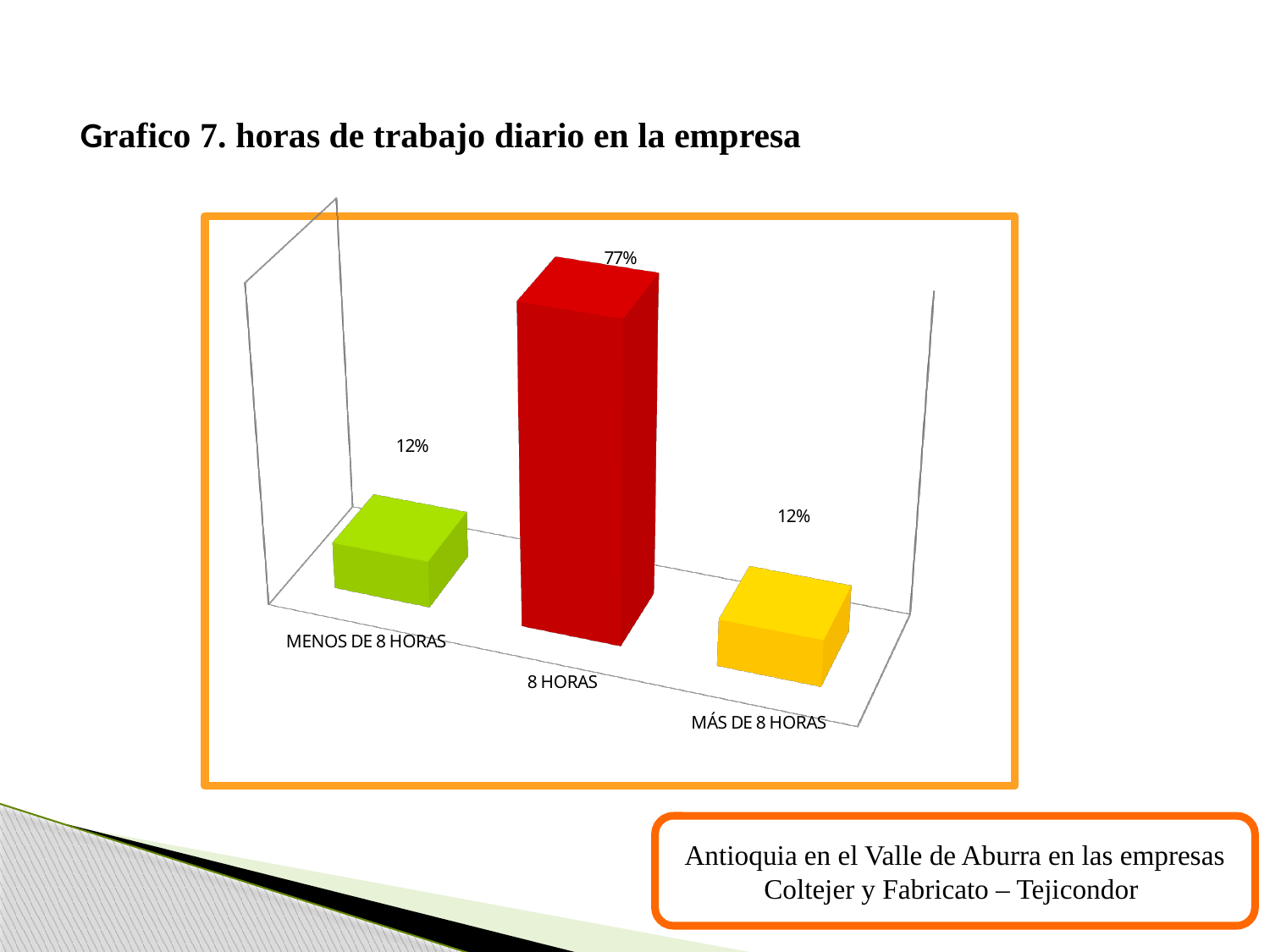
Which is larger, the value for 8 HORAS or the value for MÁS DE 8 HORAS? 8 HORAS What is the value for MENOS DE 8 HORAS? 12% Do MENOS DE 8 HORAS and MÁS DE 8 HORAS have the same value? yes What is the value for 8 HORAS? 77% Which category has the highest value? 8 HORAS What colour is the bar for 8 HORAS? red What is the difference between the values for 8 HORAS and MENOS DE 8 HORAS? 65% What is the title of the chart? Grafico 7. horas de trabajo diario en la empresa What is the value for MÁS DE 8 HORAS? 12% How many categories are shown in the chart? 3 What kind of chart is shown on the slide? bar chart